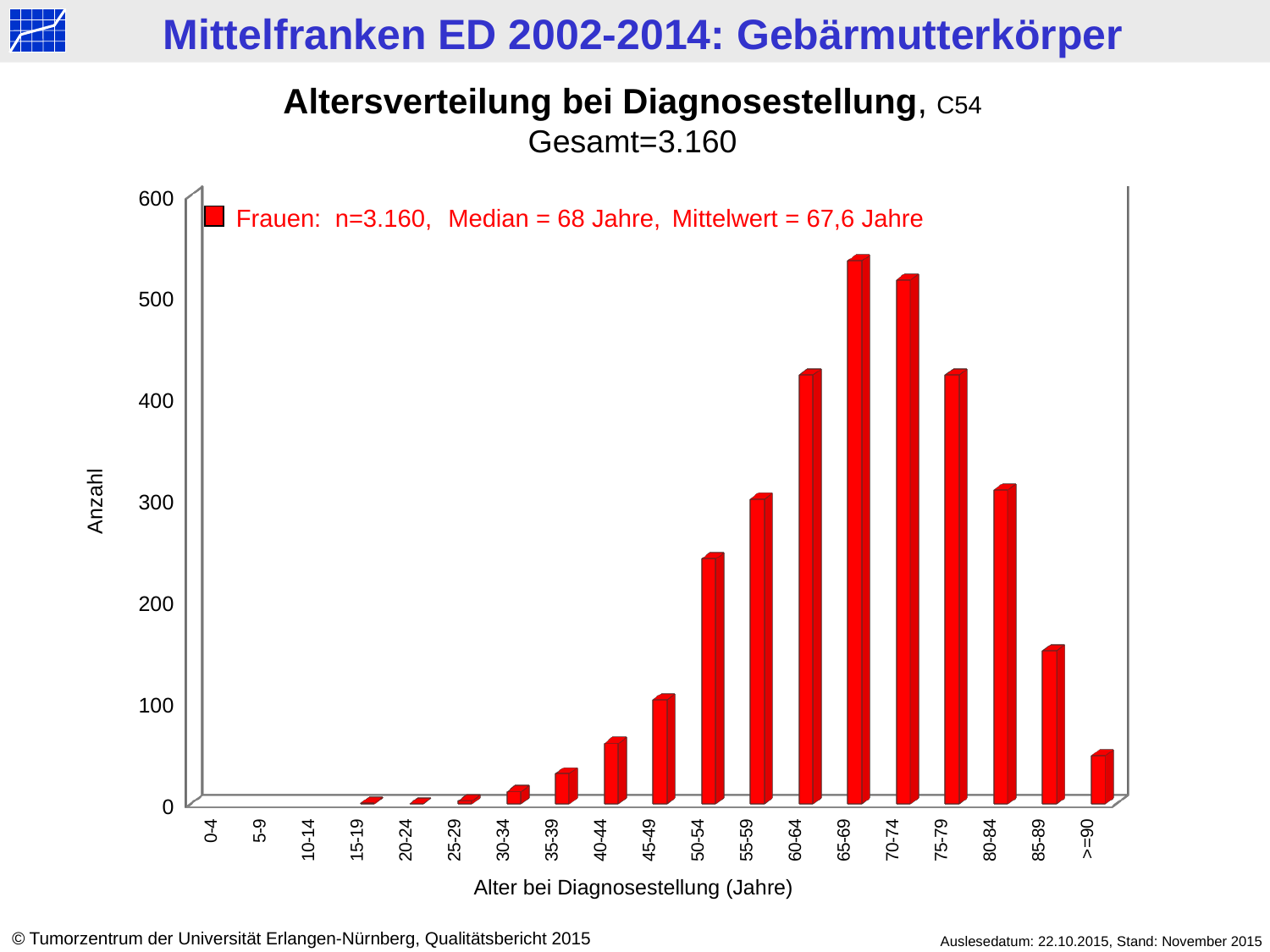
Is the value for the 85-89 age group greater or less than 100? greater Is the value for the >=90 age group greater or less than 100? less Is the value for the 40-44 age group greater or less than 100? less How many age categories are shown on the x axis? 19 Which age group has more cases, 70-74 or 60-64? 70-74 How many series does the legend list? 1 What kind of chart is shown on the slide? bar chart Do the values rise or fall from the 30-34 age group to the 65-69 age group? rise Which age group has the highest number of cases? 65-69 What median age is stated in the legend? 68 Jahre